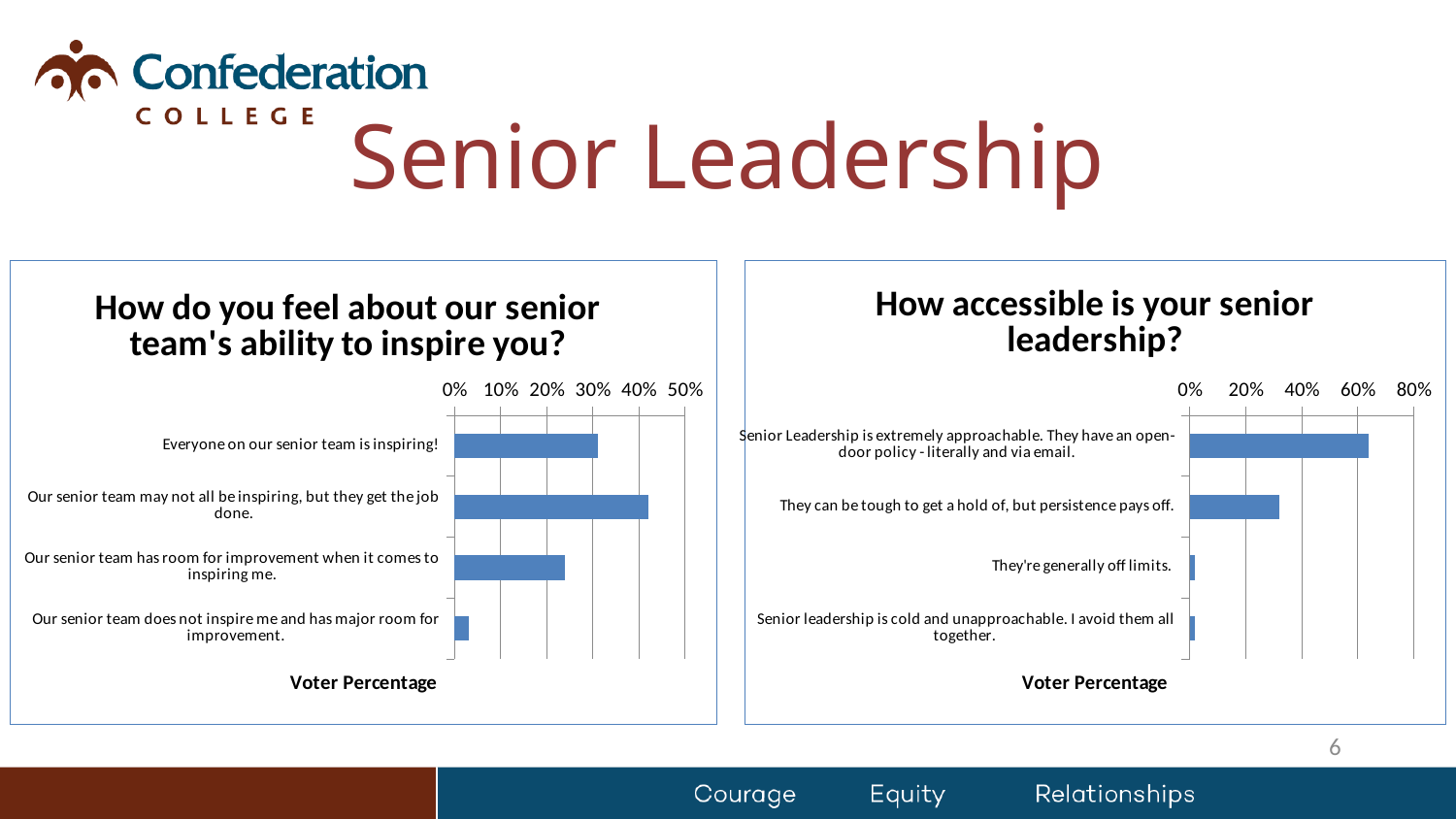
In the chart titled "How do you feel about our senior team's ability to inspire you?", which category has the highest value? Our senior team may not all be inspiring, but they get the job done. In the chart titled "How accessible is your senior leadership?", is the value for "They can be tough to get a hold of, but persistence pays off." greater or less than 40%? less In the chart titled "How do you feel about our senior team's ability to inspire you?", is the value for "Everyone on our senior team is inspiring!" greater or less than 20%? greater In the chart titled "How accessible is your senior leadership?", which is larger: the value for "They can be tough to get a hold of, but persistence pays off." or the value for "They're generally off limits."? They can be tough to get a hold of, but persistence pays off. In the chart titled "How accessible is your senior leadership?", is the value for "Senior Leadership is extremely approachable. They have an open-door policy - literally and via email." greater or less than 60%? greater In the chart titled "How accessible is your senior leadership?", which category has the highest value? Senior Leadership is extremely approachable. They have an open-door policy - literally and via email. In the chart titled "How do you feel about our senior team's ability to inspire you?", which category has the lowest value? Our senior team does not inspire me and has major room for improvement. In the chart titled "How do you feel about our senior team's ability to inspire you?", how many categories are plotted? 4 In the chart titled "How do you feel about our senior team's ability to inspire you?", what kind of chart is shown? bar chart In the chart titled "How accessible is your senior leadership?", how many categories are plotted? 4 In the chart titled "How accessible is your senior leadership?", what is the axis label shown below the bars? Voter Percentage